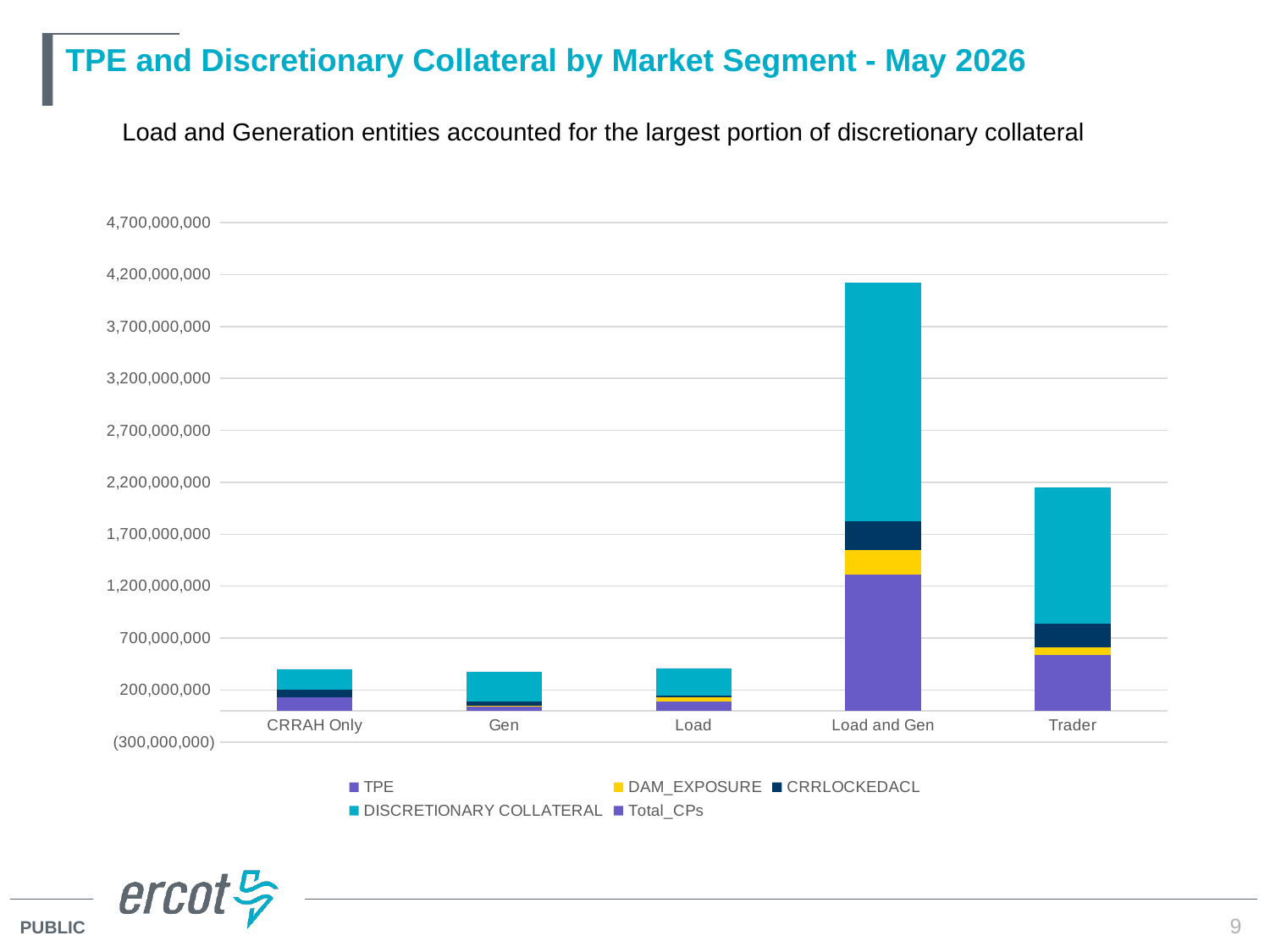
Which series is shown in yellow in the legend? DAM_EXPOSURE What kind of chart is shown on the slide? Stacked bar chart Is the top of the Trader stacked bar greater or less than 1,700,000,000? greater How many series does the legend list? 5 Is the top of the Load and Gen stacked bar greater or less than 3,700,000,000? greater Which market segment has the tallest stacked bar? Load and Gen Is the top of the Gen stacked bar greater or less than 700,000,000? less Which stacked bar is taller, Trader or CRRAH Only? Trader What is the title of the slide containing the chart? TPE and Discretionary Collateral by Market Segment - May 2026 How many market segment categories are shown on the x axis? 5 Which stacked bar is taller, Load and Gen or Trader? Load and Gen